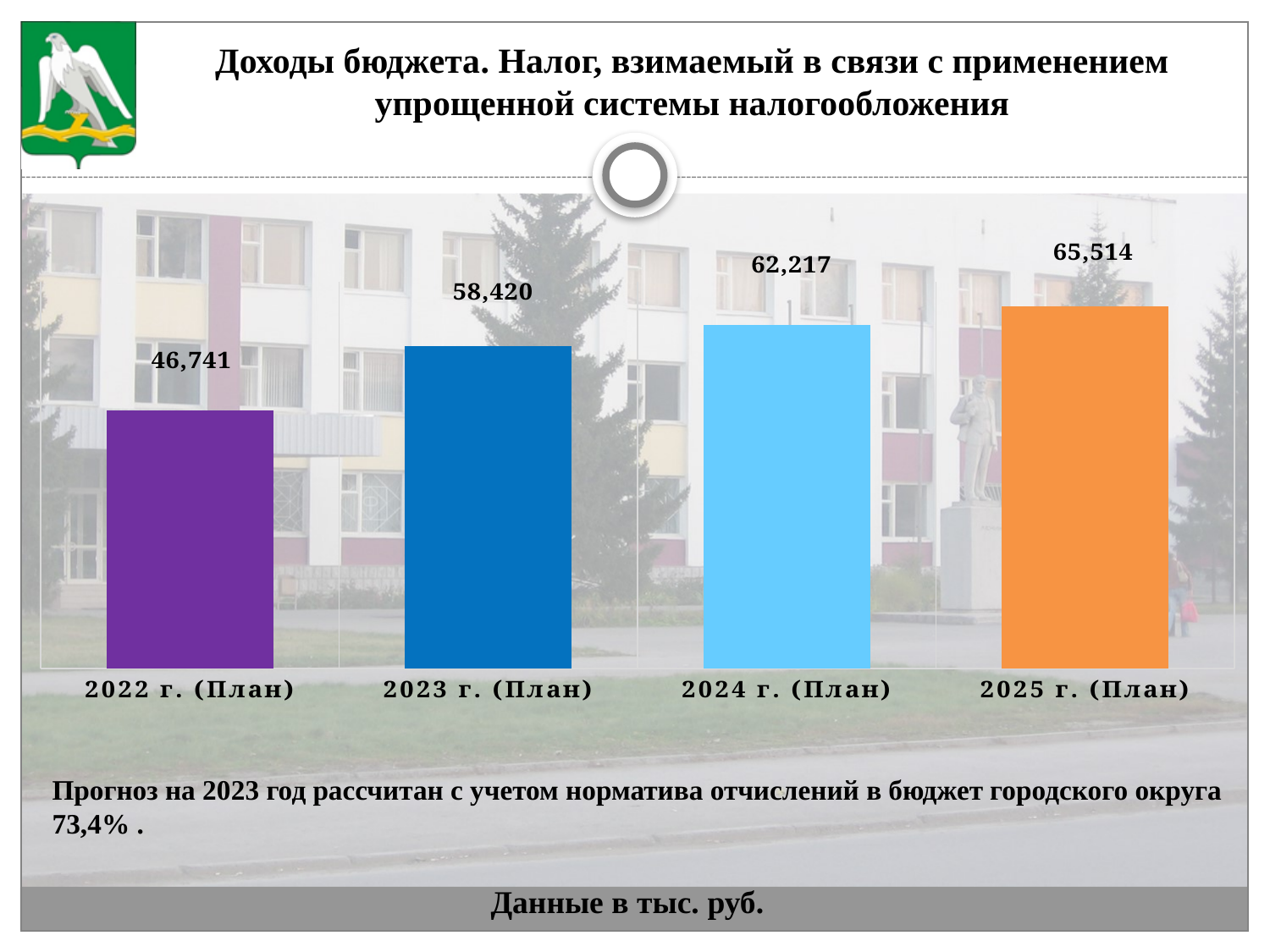
Which year has the lowest value? 2022 г. (План) Do the values rise or fall from 2022 г. (План) to 2025 г. (План)? Rise What is the value for 2022 г. (План)? 46,741 What is the difference between the values for 2023 г. (План) and 2022 г. (План)? 11,679 Which is larger, the value for 2024 г. (План) or 2023 г. (План)? 2024 г. (План) What is the value for 2025 г. (План)? 65,514 What is the value for 2024 г. (План)? 62,217 What kind of chart is shown on the slide? Bar chart What is the value for 2023 г. (План)? 58,420 What is the difference between the values for 2025 г. (План) and 2024 г. (План)? 3,297 How many bars are shown in the chart? 4 Which year has the highest value? 2025 г. (План)